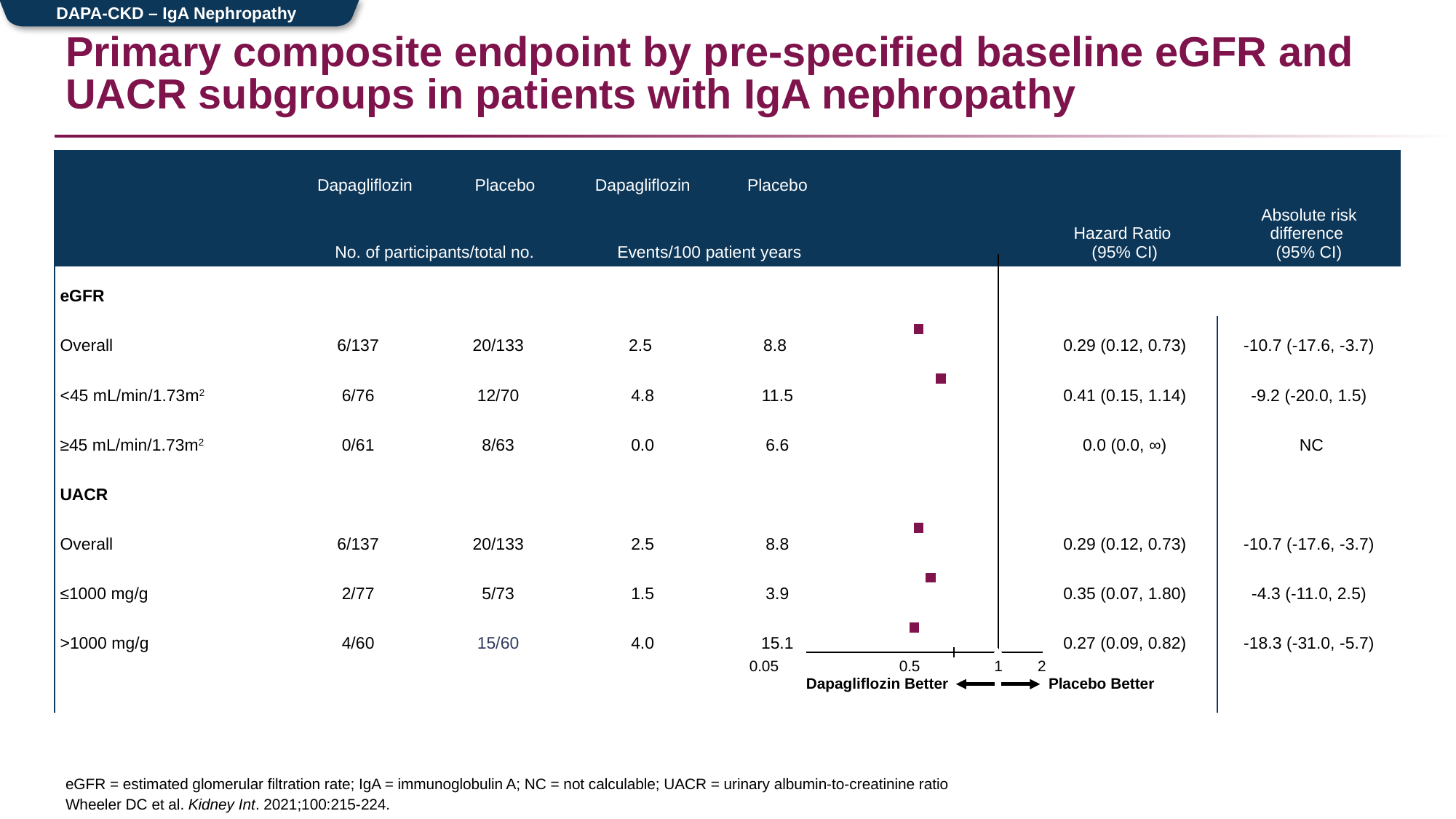
What is the difference between the hazard ratio for UACR ≤1000 mg/g and UACR >1000 mg/g? 0.08 Among the plotted eGFR rows, which has the highest hazard ratio? <45 mL/min/1.73m² Is the hazard ratio for the UACR ≤1000 mg/g subgroup greater or less than 1? less How many hazard ratio points are plotted on the forest plot? 5 Which UACR subgroup has the lowest hazard ratio? >1000 mg/g Is the hazard ratio for the eGFR <45 mL/min/1.73m² subgroup greater or less than 0.5? less Which has the larger hazard ratio: the eGFR <45 mL/min/1.73m² subgroup or the UACR ≤1000 mg/g subgroup? eGFR <45 mL/min/1.73m² What is the absolute risk difference (95% CI) for the UACR >1000 mg/g subgroup? -18.3 (-31.0, -5.7) What is the hazard ratio (95% CI) for the UACR >1000 mg/g subgroup? 0.27 (0.09, 0.82) What is the hazard ratio (95% CI) for the eGFR <45 mL/min/1.73m² subgroup? 0.41 (0.15, 1.14) What label appears to the left of the arrows beneath the hazard ratio axis? Dapagliflozin Better What kind of chart is shown on the slide? Forest plot